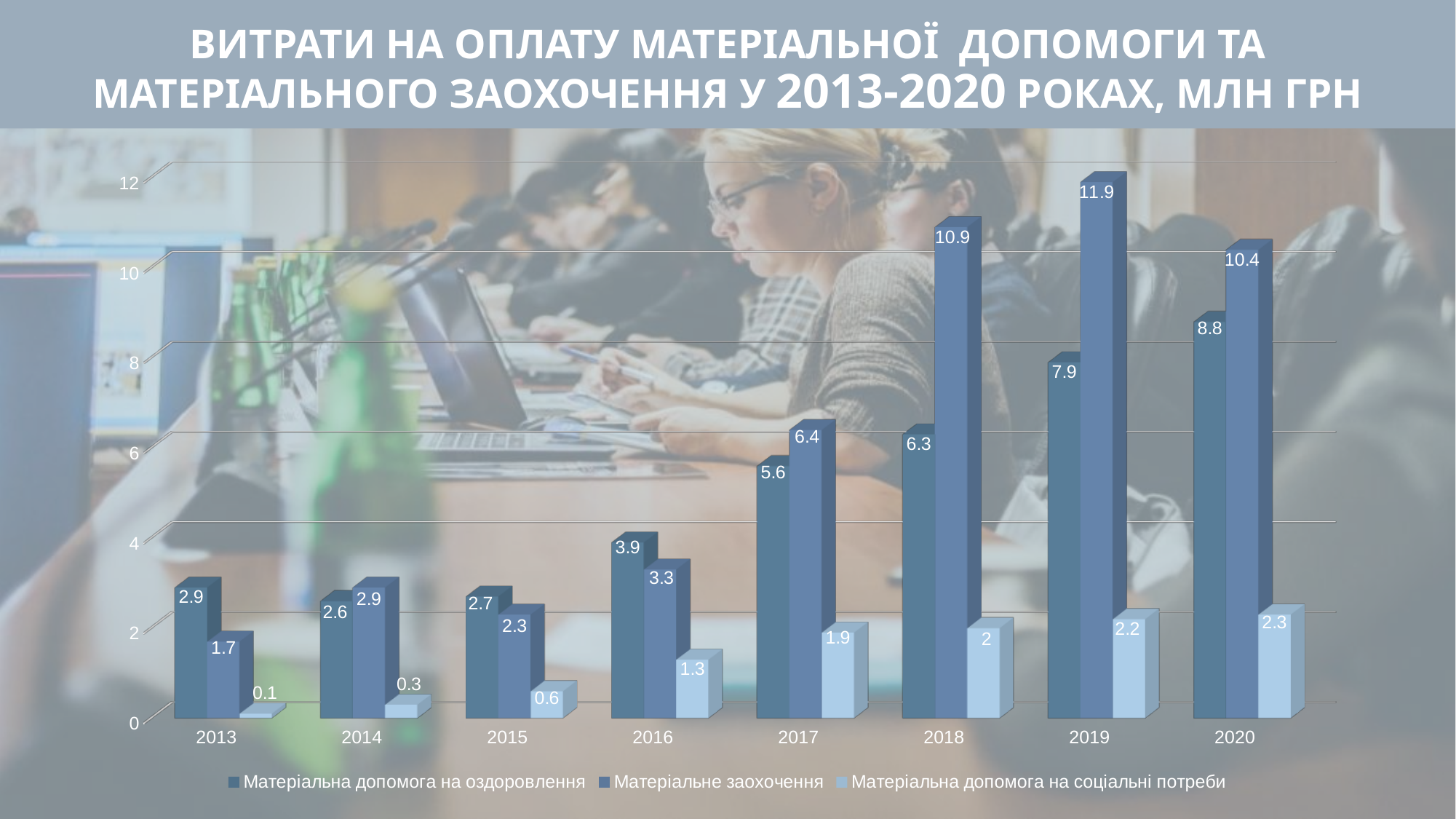
What is the total of the three series in 2020? 21.5 How many years are shown on the x axis? 8 What is the value for Матеріальна допомога на соціальні потреби in 2013? 0.1 In which year is Матеріальне заохочення highest? 2019 What is the difference between Матеріальне заохочення and Матеріальна допомога на оздоровлення in 2018? 4.6 What is the value for Матеріальна допомога на оздоровлення in 2020? 8.8 In which year is Матеріальна допомога на оздоровлення lowest? 2014 Does Матеріальна допомога на соціальні потреби rise or fall from 2013 to 2020? Rise What is the value for Матеріальне заохочення in 2019? 11.9 What kind of chart is shown on the slide? Bar chart Which is larger in 2016: Матеріальна допомога на оздоровлення or Матеріальне заохочення? Матеріальна допомога на оздоровлення How many series does the legend list? 3